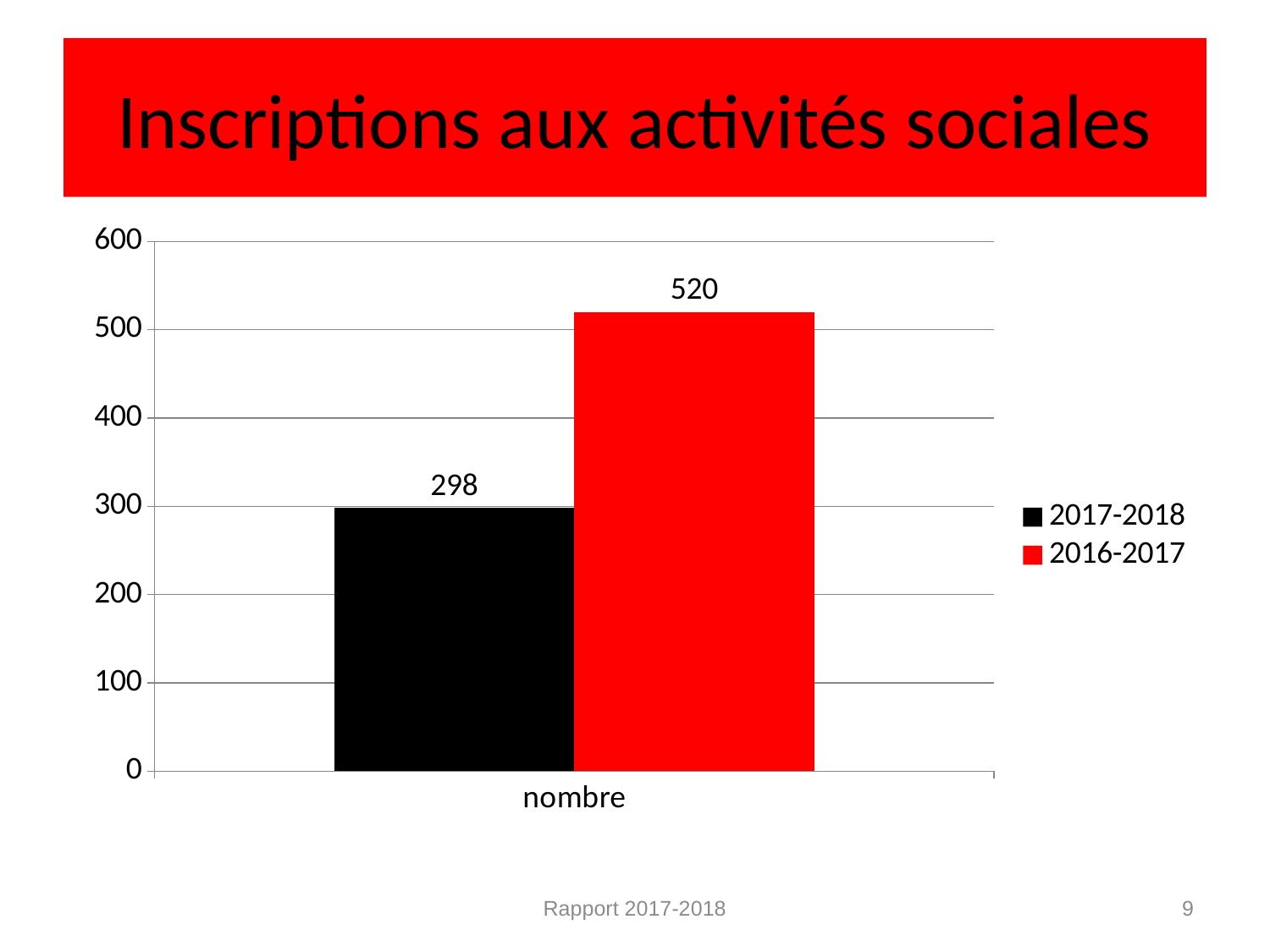
Which series has the lower value? 2017-2018 What kind of chart is shown on the slide? bar chart Which series has the higher value? 2016-2017 Is the value for 2016-2017 greater or less than 500? greater What is the value for 2017-2018? 298 Is the value for 2017-2018 larger or smaller than the value for 2016-2017? smaller What is the category label on the x axis? nombre How many series does the legend list? 2 What is the value for 2016-2017? 520 Is the value for 2017-2018 greater or less than 300? less What is the difference between the 2016-2017 value and the 2017-2018 value? 222 What colour is the bar for 2016-2017? red